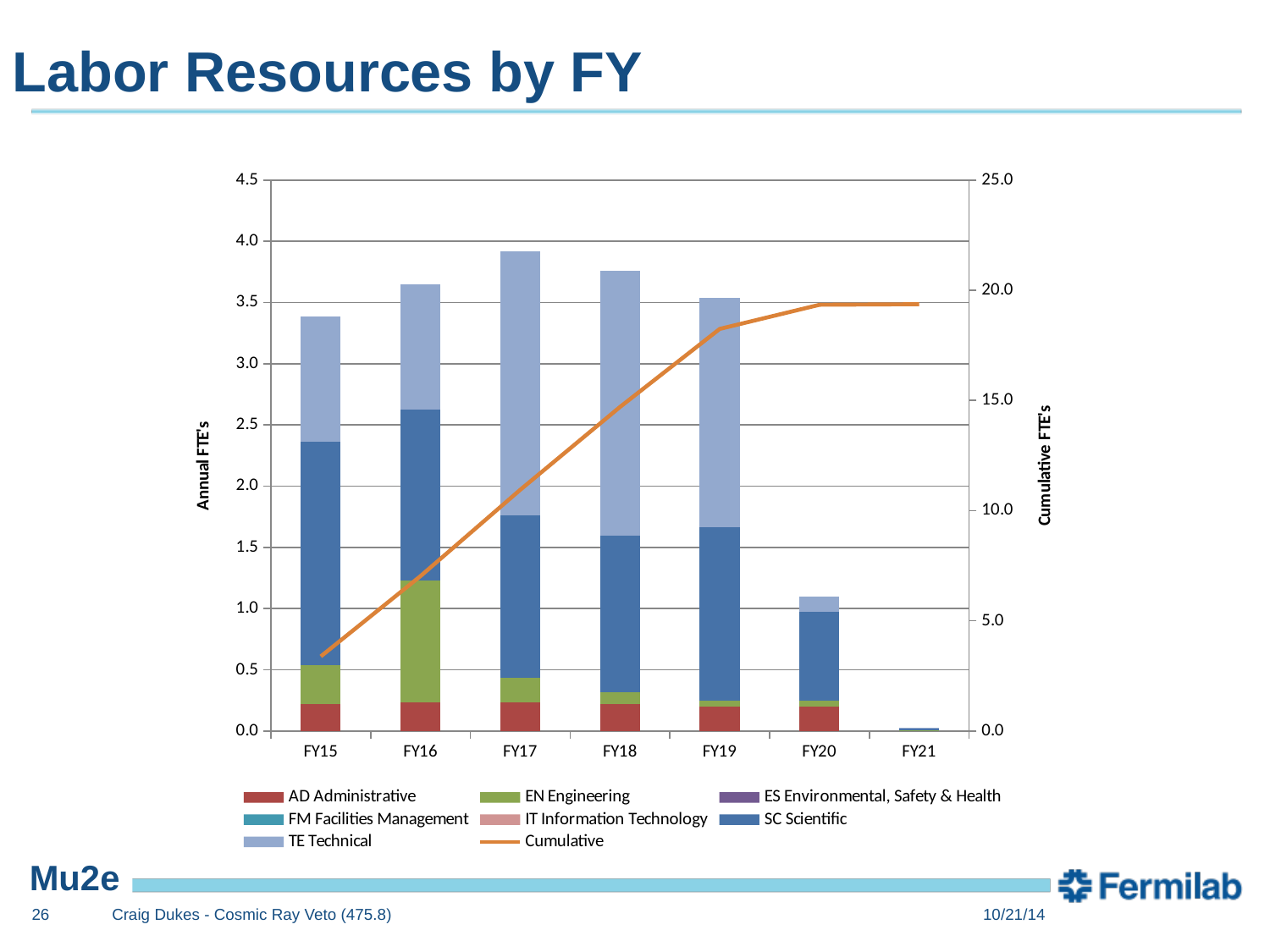
How many fiscal years are shown on the x axis? 7 Which fiscal year has the shortest stacked bar? FY21 Is the total stacked bar for FY17 greater or less than 3.5 Annual FTE's? greater Does the Cumulative line rise or fall from FY15 to FY19? rises Which fiscal year has the tallest stacked bar? FY17 What is the label of the right-hand vertical axis? Cumulative FTE's Which has the larger total stacked bar, FY16 or FY20? FY16 Is the Cumulative value at FY15 greater or less than 5.0 Cumulative FTE's? less What kind of chart is shown on the slide? combination bar and line chart How many entries does the legend list? 8 Is the Cumulative value at FY20 greater or less than 15.0 Cumulative FTE's? greater